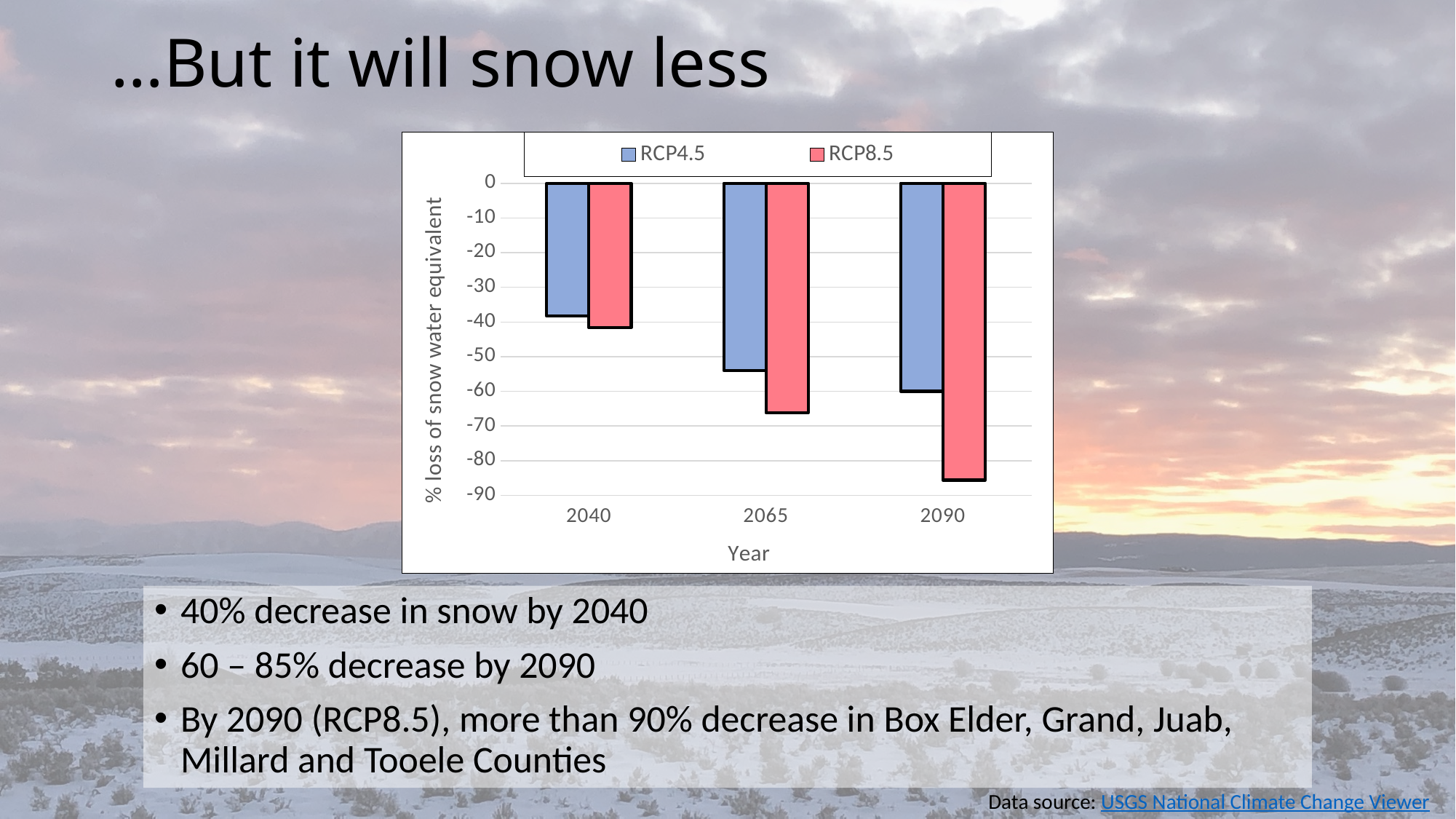
Which year and scenario shows the largest percentage loss of snow water equivalent? 2090, RCP8.5 What kind of chart is shown on the slide? bar chart What is the label on the y axis of the chart? % loss of snow water equivalent Which shows a larger loss of snow water equivalent: RCP8.5 in 2065 or RCP4.5 in 2090? RCP8.5 in 2065 Is the RCP8.5 value for 2090 greater or less than -80? less How many years are shown on the x axis of the chart? 3 Is the RCP4.5 value for 2040 greater or less than -30? less Is the RCP8.5 value for 2040 greater or less than -50? greater Do the RCP8.5 values rise or fall from 2040 to 2090? fall Which year and scenario shows the smallest percentage loss of snow water equivalent? 2040, RCP4.5 How many series does the chart's legend list? 2